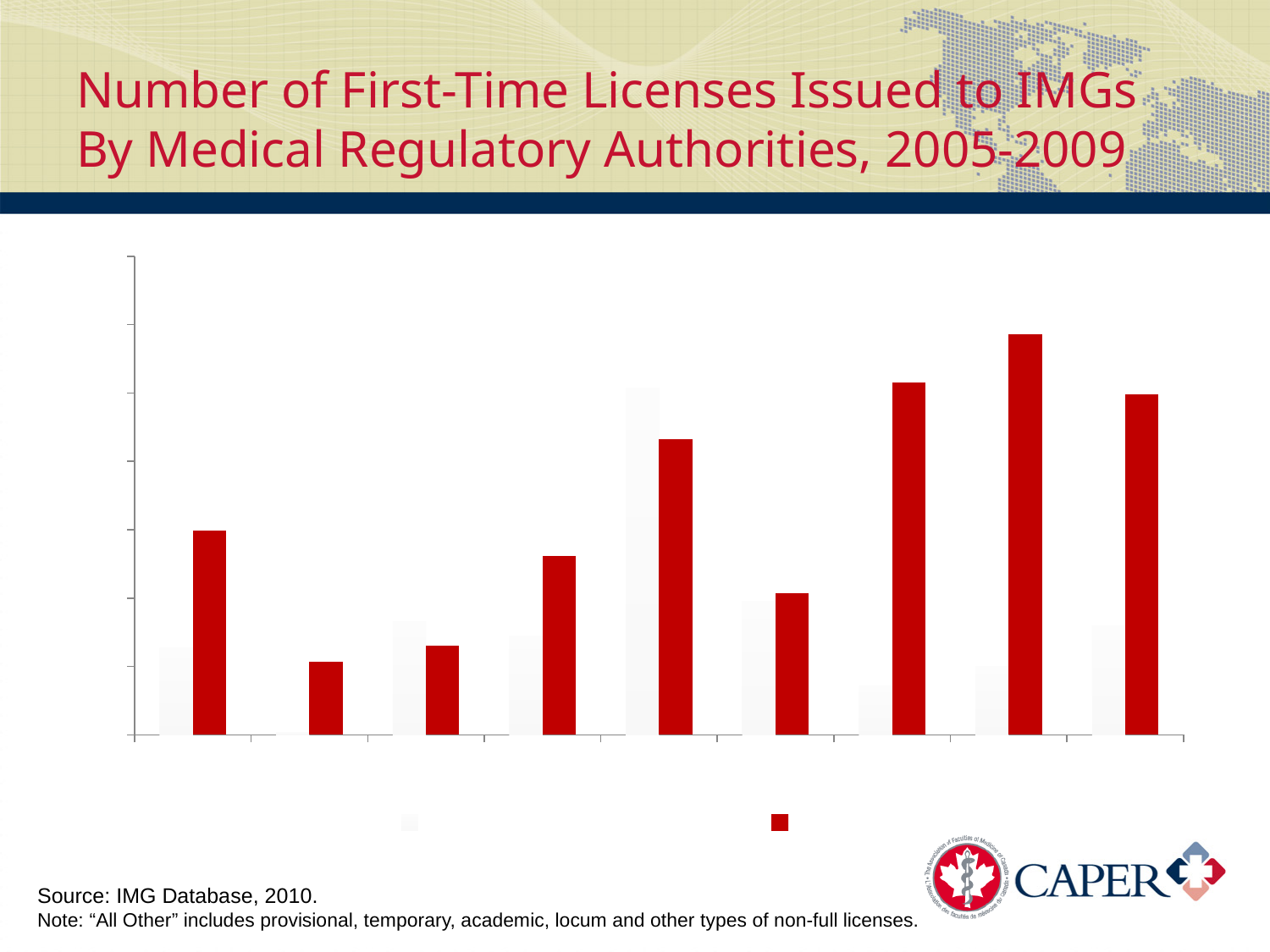
What kind of chart is shown on the slide? bar chart Is the first red bar from the left taller or shorter than the second red bar? taller Is the fifth red bar from the left taller or shorter than the sixth red bar? taller How many categories are plotted along the x axis? 9 Counting from the left, which red bar is the tallest? the eighth What colour are the bars of the taller series in the chart? red Counting from the left, which red bar is the shortest? the second Do the red bars rise steadily from left to right across the chart? no What is the title of the chart on the slide? Number of First-Time Licenses Issued to IMGs By Medical Regulatory Authorities, 2005-2009 How many series does the legend list? 2